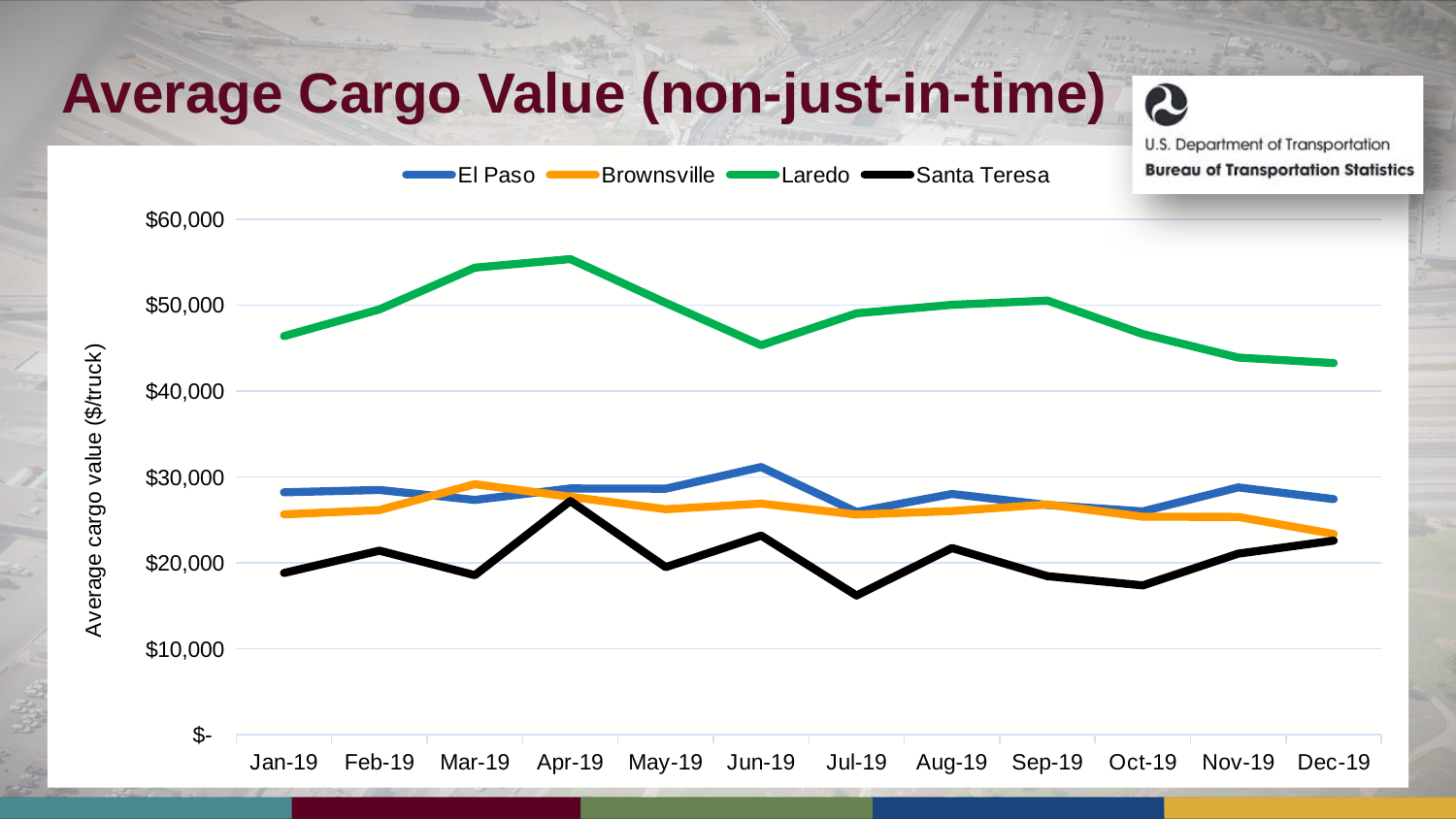
Which is larger in Apr-19: the value for Santa Teresa or the value for Santa Teresa in Jul-19? Apr-19 Which series has the highest average cargo value throughout 2019? Laredo Is the value for Laredo in Jun-19 greater or less than $50,000? less How many series does the legend list? 4 Does the Laredo line rise or fall from Sep-19 to Dec-19? Fall What kind of chart is shown on the slide? Line chart Is the value for Santa Teresa in Jul-19 greater or less than $20,000? less How many months are plotted along the x axis? 12 Is the value for Laredo in Apr-19 greater or less than $50,000? greater In which month does the Laredo line reach its highest value? Apr-19 What is the label on the vertical axis? Average cargo value ($/truck) Which series has the lowest value in Jan-19? Santa Teresa